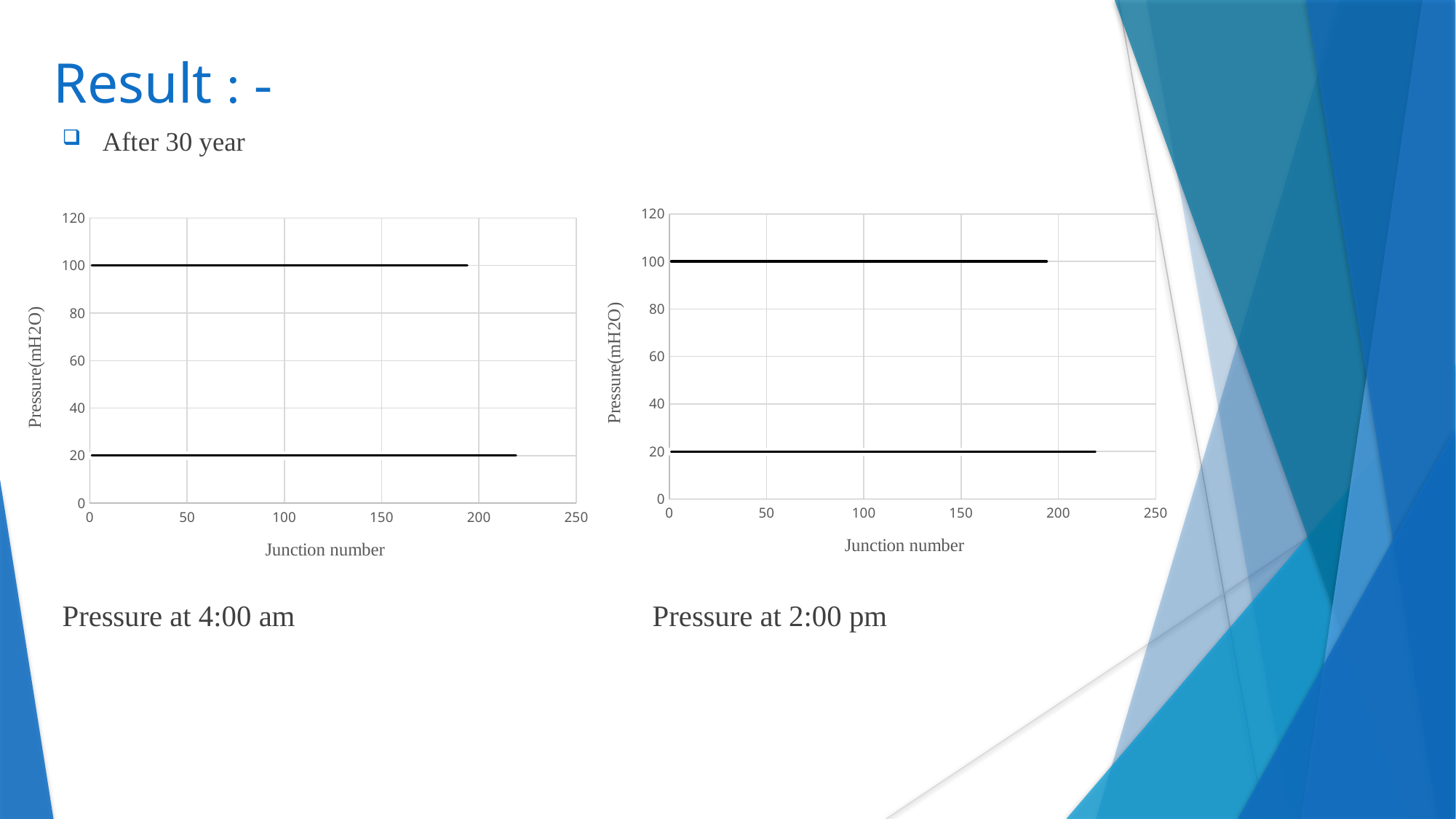
In the left chart (Pressure at 4:00 am), what is the difference in pressure between the upper line and the lower line? 80 In the right chart (Pressure at 2:00 pm), does the pressure rise, fall, or stay flat as the junction number increases? stays flat In the left chart (Pressure at 4:00 am), at what pressure value does the lower line lie? 20 What is the maximum value shown on the y axis of the right chart (Pressure at 2:00 pm)? 120 In the left chart (Pressure at 4:00 am), does the pressure rise, fall, or stay flat as the junction number increases? stays flat In the left chart (Pressure at 4:00 am), is the lower line greater or less than 40? less In the right chart (Pressure at 2:00 pm), at what pressure value does the upper line lie? 100 In the right chart (Pressure at 2:00 pm), at what pressure value does the lower line lie? 20 In the right chart (Pressure at 2:00 pm), is the upper line greater or less than 80? greater What is the title of the y axis on the left chart (Pressure at 4:00 am)? Pressure(mH2O) In the left chart (Pressure at 4:00 am), at what pressure value does the upper line lie? 100 What is the title of the x axis on the right chart (Pressure at 2:00 pm)? Junction number